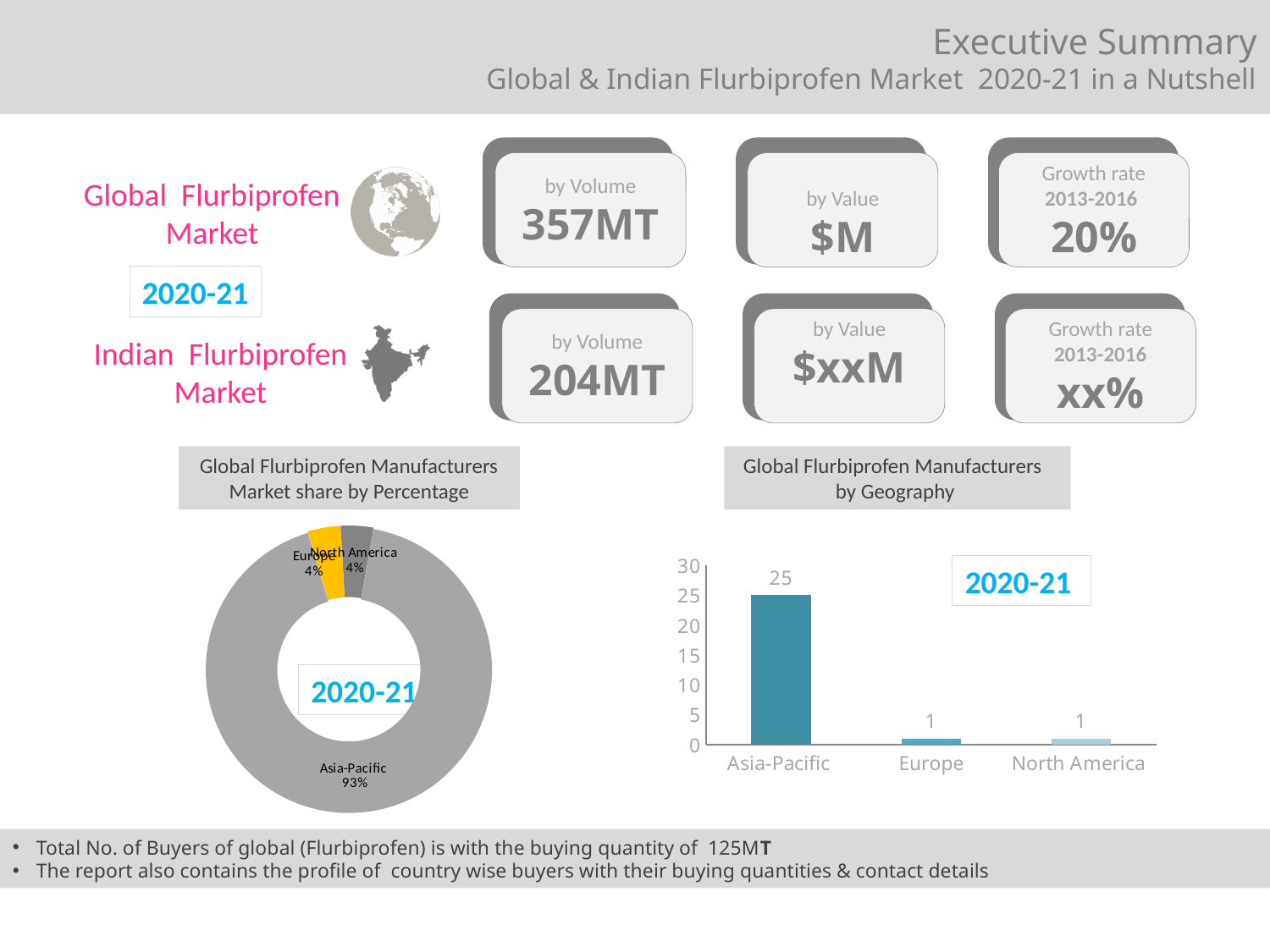
In the 'Global Flurbiprofen Manufacturers by Geography' chart, what is the value for Asia-Pacific? 25 In the 'Global Flurbiprofen Manufacturers by Geography' chart, how many regions are shown on the x axis? 3 In the 'Global Flurbiprofen Manufacturers Market share by Percentage' chart, what share does Asia-Pacific hold? 93% In the 'Global Flurbiprofen Manufacturers by Geography' chart, is the value for Asia-Pacific greater or less than 20? greater In the 'Global Flurbiprofen Manufacturers by Geography' chart, what is the value for Europe? 1 What kind of chart is 'Global Flurbiprofen Manufacturers Market share by Percentage'? Doughnut chart In the 'Global Flurbiprofen Manufacturers Market share by Percentage' chart, what year label is shown in the centre of the doughnut? 2020-21 In the 'Global Flurbiprofen Manufacturers Market share by Percentage' chart, which region has the largest share? Asia-Pacific In the 'Global Flurbiprofen Manufacturers Market share by Percentage' chart, what share does Europe hold? 4% What kind of chart is 'Global Flurbiprofen Manufacturers by Geography'? Bar chart In the 'Global Flurbiprofen Manufacturers by Geography' chart, what is the difference between the values for Asia-Pacific and North America? 24 In the 'Global Flurbiprofen Manufacturers by Geography' chart, which region has the highest value? Asia-Pacific